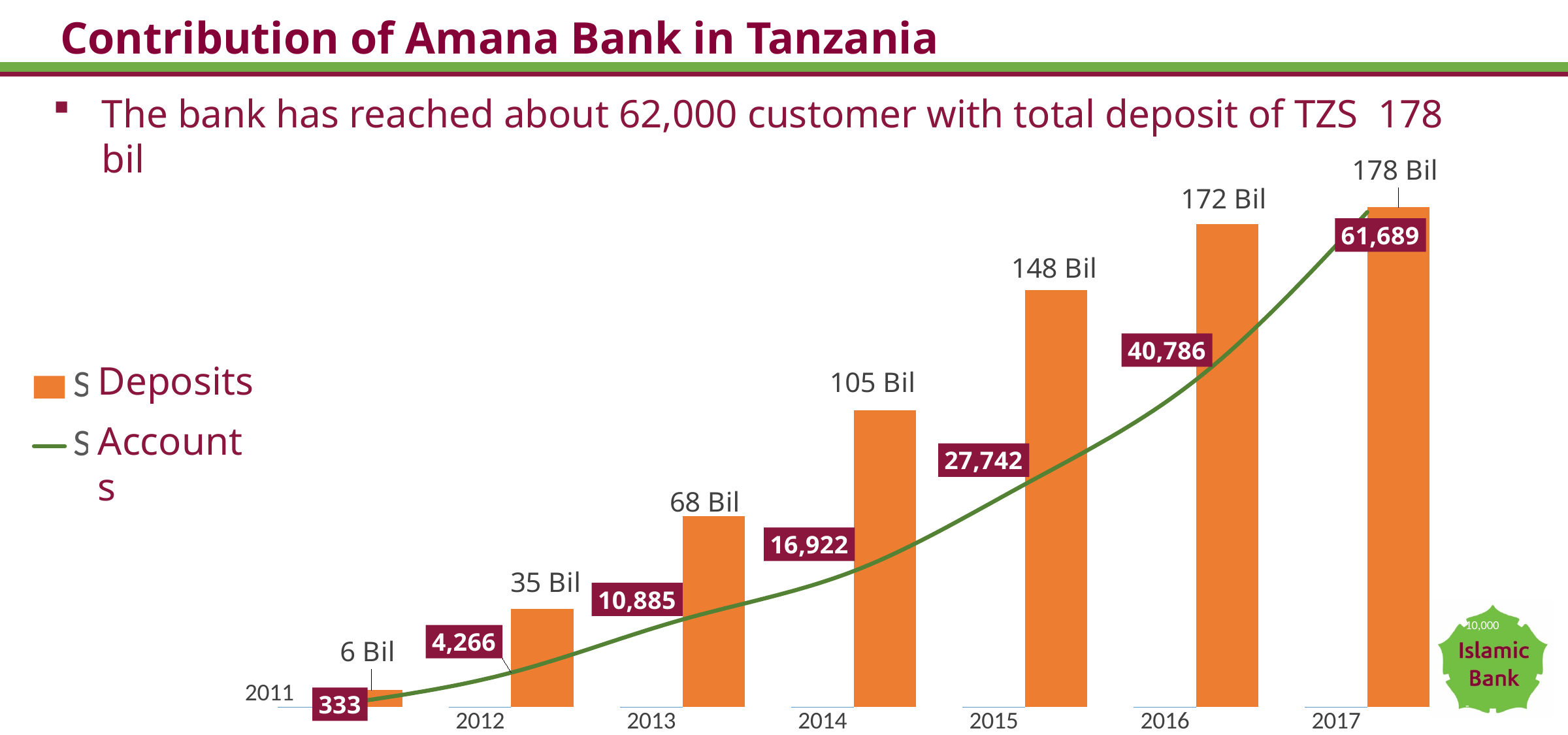
Do the Accounts values rise or fall from 2011 to 2017? rise What is the difference in Accounts between 2017 and 2016? 20,903 What is the value of Deposits for 2014? 105 Bil What is the value of Accounts for 2011? 333 Which series is shown as a line rather than bars? Accounts Which is larger, the Deposits value for 2013 or for 2015? 2015 What is the difference in Deposits between 2017 and 2016? 6 Bil What is the value of Accounts for 2016? 40,786 Which year has the lowest Accounts value? 2011 How many series does the legend list? 2 Which year has the highest Deposits value? 2017 How many years are shown on the x axis? 7